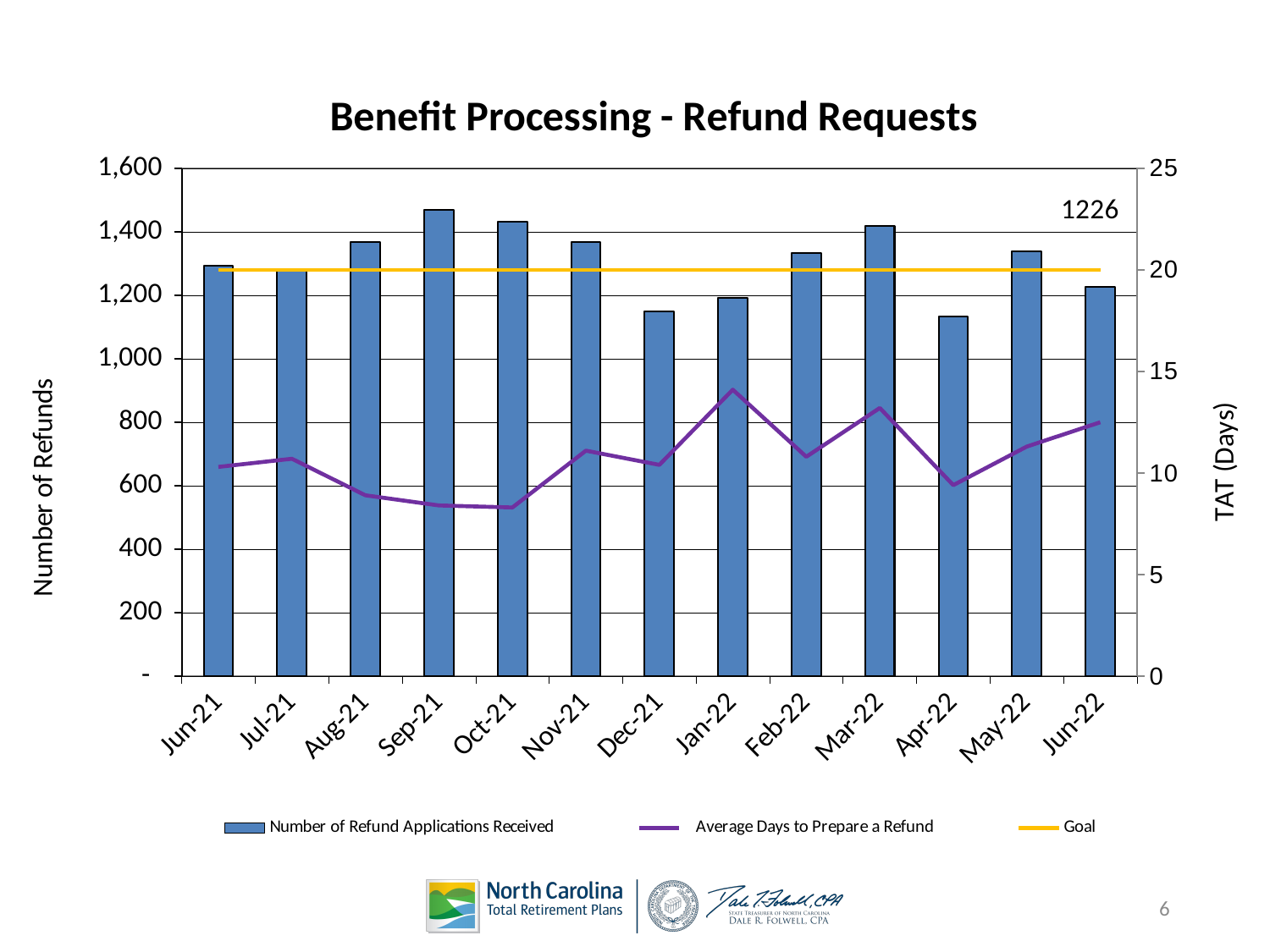
What value does the Goal line sit at on the TAT (Days) axis? 20 Is the number of refund applications received in Sep-21 greater or less than 1,400? greater Which month has more refund applications received, Mar-22 or Apr-22? Mar-22 What kind of chart is this? Combined bar and line chart Which month has the highest number of refund applications received? Sep-21 Is the number of refund applications received in Dec-21 greater or less than 1,200? less Is the average days to prepare a refund in Oct-21 greater or less than 10? less In which month is the average days to prepare a refund the highest? Jan-22 What is the number of refund applications received in Jun-22? 1226 Does the average days to prepare a refund rise or fall from Jul-21 to Oct-21? fall How many months are shown on the x axis? 13 How many series does the legend list? 3